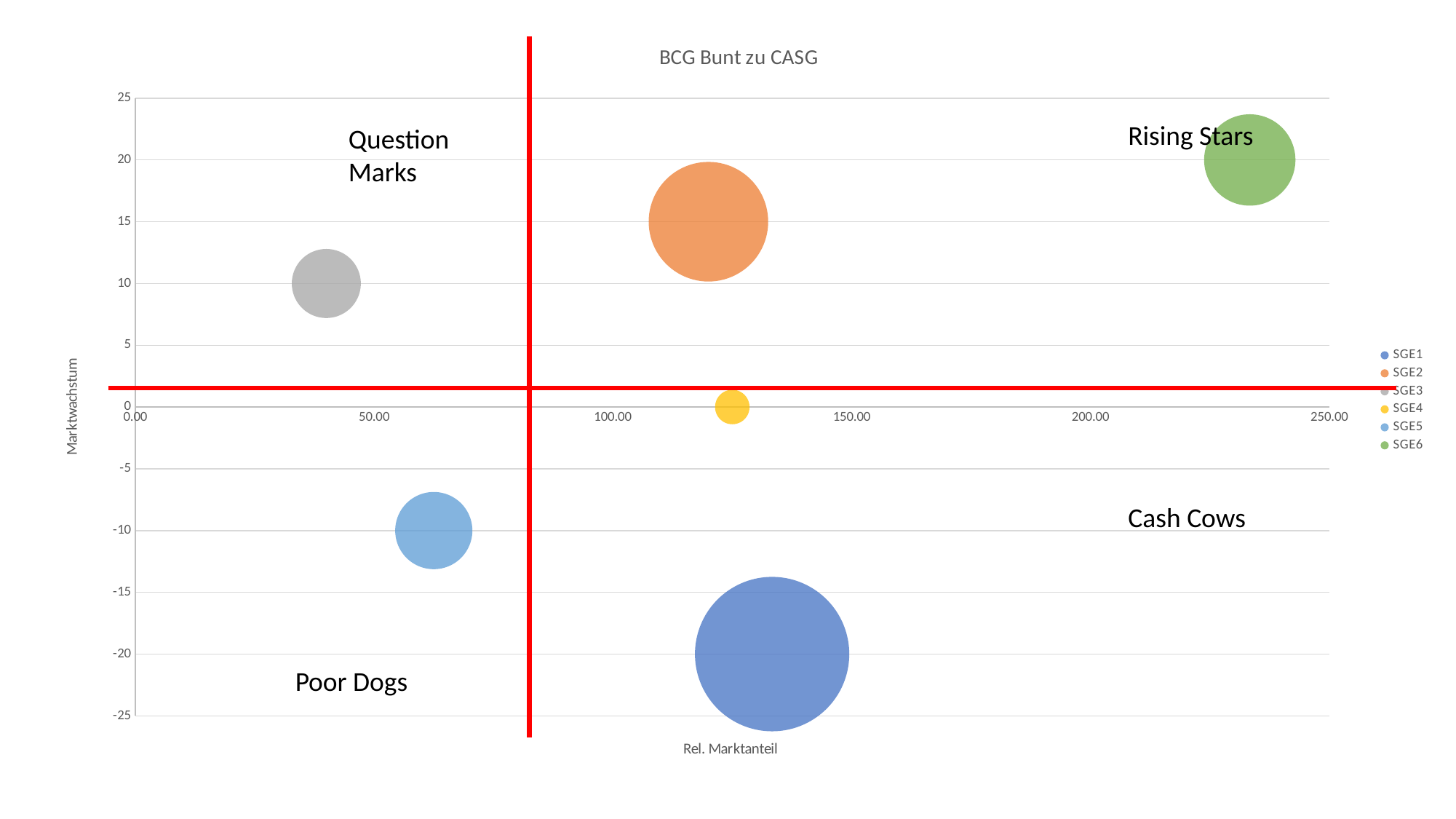
What is the Marktwachstum value for SGE3? 10 Which quadrant label appears in the top-right area of the chart? Rising Stars Which has the higher Marktwachstum value, SGE2 or SGE5? SGE2 Is the Rel. Marktanteil value for SGE3 greater or less than 50.00? less How many bubbles are plotted on the chart? 6 Is the Rel. Marktanteil value for SGE6 greater or less than 200.00? greater What is the title of the chart? BCG Bunt zu CASG What is the Marktwachstum value for SGE2? 15 Which series has the lowest Marktwachstum value? SGE1 How many series does the legend list? 6 Which series has the highest Marktwachstum value? SGE6 What kind of chart is shown on the slide? Bubble chart